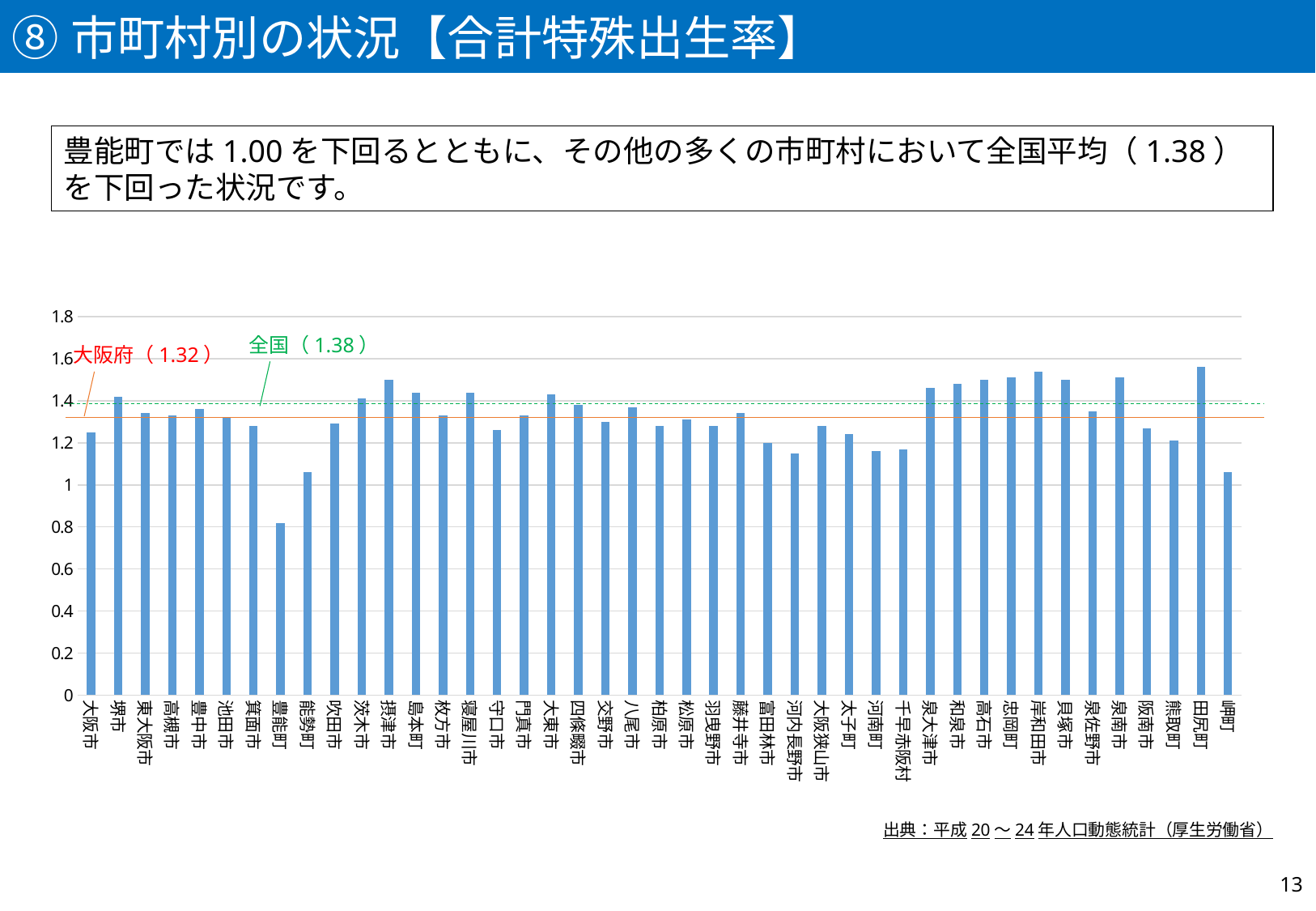
How many municipalities are plotted on the x axis of the chart? 43 What value is given for 大阪府 on the chart? 1.32 What value is given for 全国 (national average) on the chart? 1.38 What kind of chart is shown on the slide? bar chart Is the value for 田尻町 greater or less than 1.4? greater Is the value for 河内長野市 greater or less than 1.2? less Is the value for 摂津市 greater or less than 1.4? greater Which has the larger value, 豊能町 or 能勢町? 能勢町 Which has the larger value, 摂津市 or 守口市? 摂津市 Which municipality has the lowest value in the chart? 豊能町